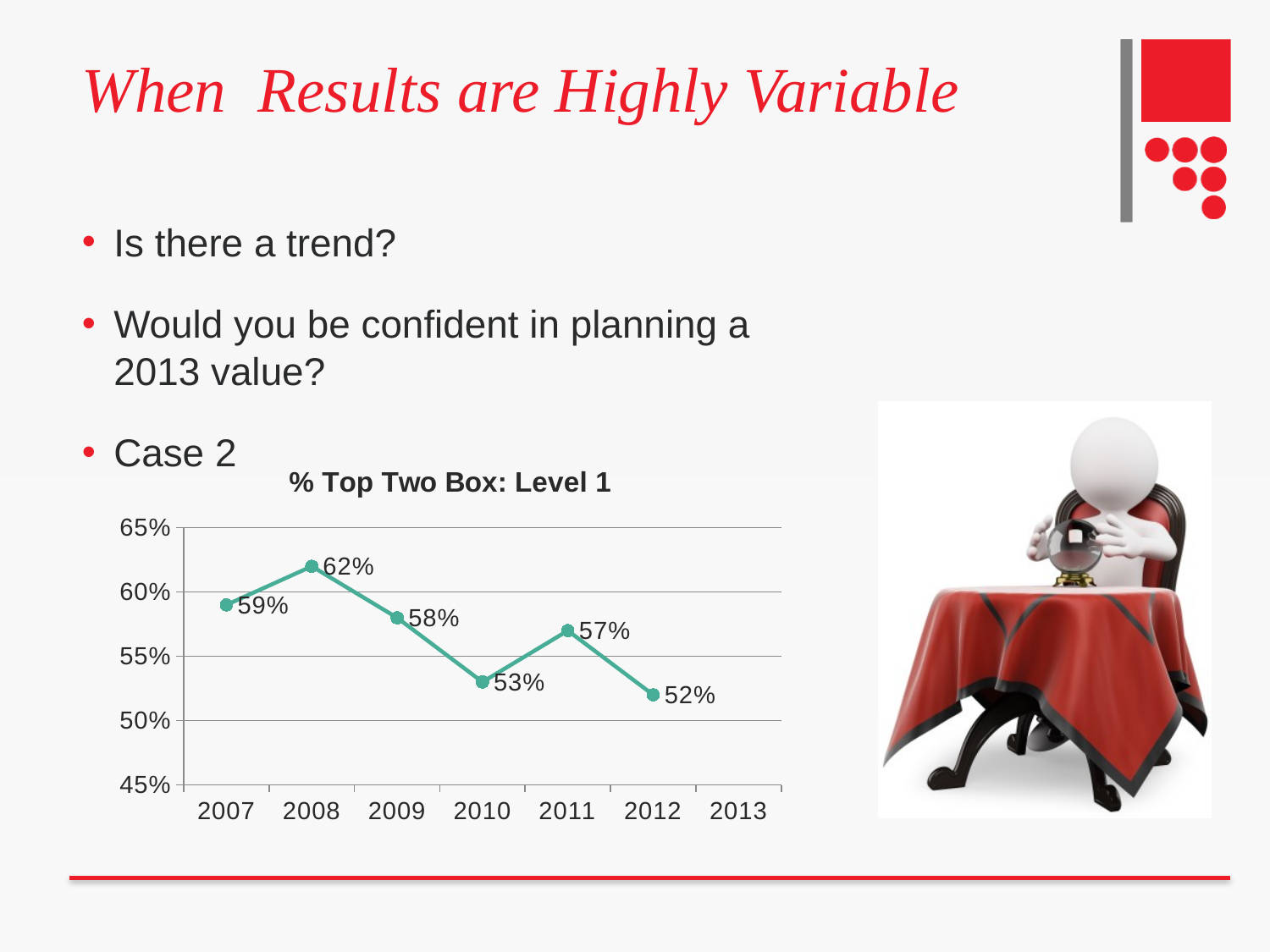
What is the value for 2010? 53% Which year has the lowest value? 2012 How many data points are plotted on the chart? 6 Which is larger, the value for 2009 or the value for 2011? 2009 What is the value for 2008? 62% Which year has the highest value? 2008 Do the values generally rise or fall from 2007 to 2012? fall What is the difference between the 2007 and 2012 values? 7% What is the title of the chart? % Top Two Box: Level 1 Is the value for 2010 greater or less than 55%? less What is the value for 2012? 52% What kind of chart is shown? line chart